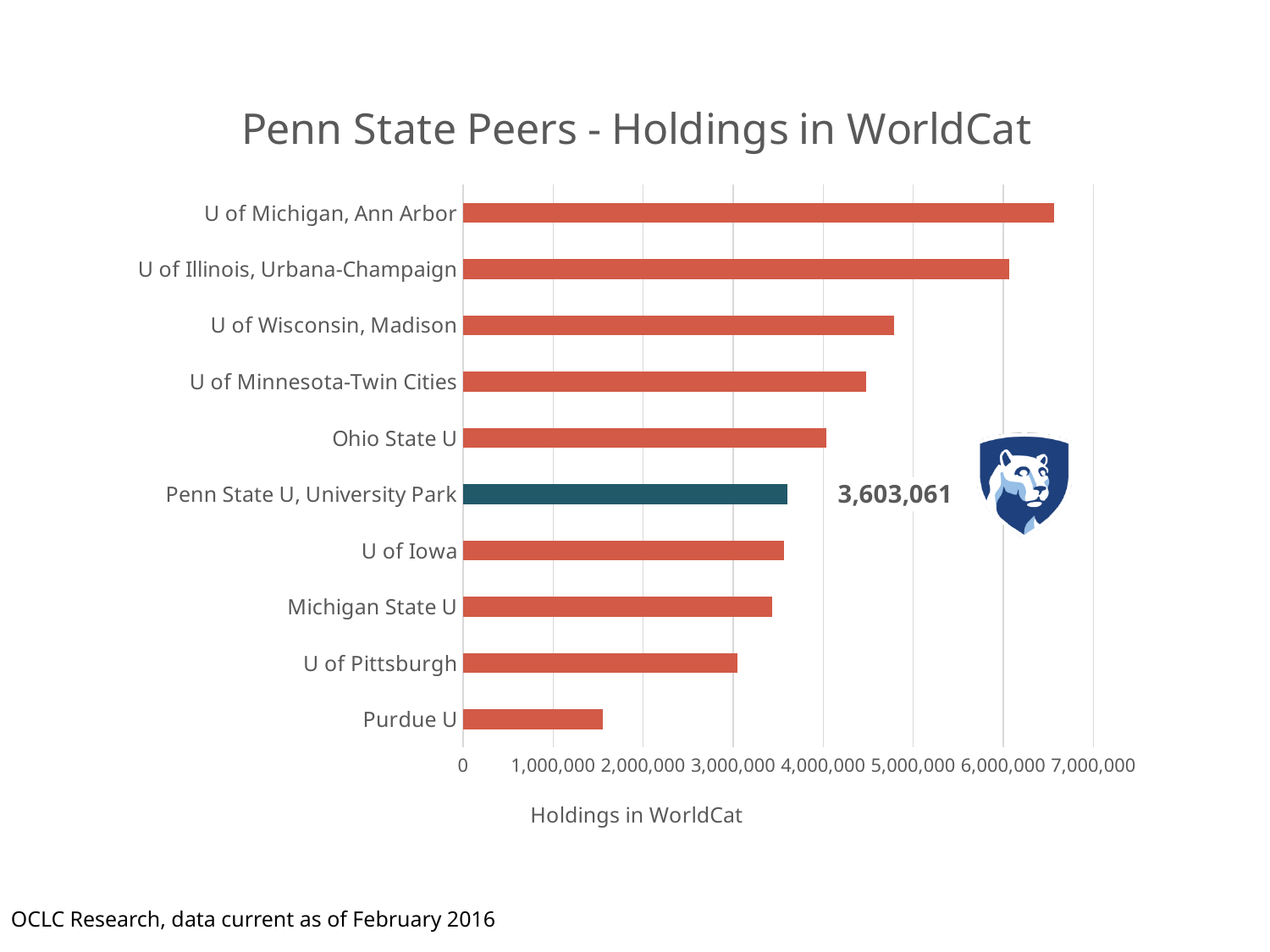
Which institution has the highest holdings in WorldCat? U of Michigan, Ann Arbor Which institution has the lowest holdings in WorldCat? Purdue U What is the value for Penn State U, University Park? 3,603,061 Is the value for Michigan State U greater or less than 4,000,000? less What is the title of the chart? Penn State Peers - Holdings in WorldCat Which has more holdings in WorldCat, U of Wisconsin, Madison or U of Minnesota-Twin Cities? U of Wisconsin, Madison Which has more holdings in WorldCat, U of Michigan, Ann Arbor or U of Illinois, Urbana-Champaign? U of Michigan, Ann Arbor Is the value for U of Michigan, Ann Arbor greater or less than 6,000,000? greater Is the value for U of Wisconsin, Madison greater or less than 5,000,000? less What type of chart is shown on the slide? Bar chart How many institutions are shown in the chart? 10